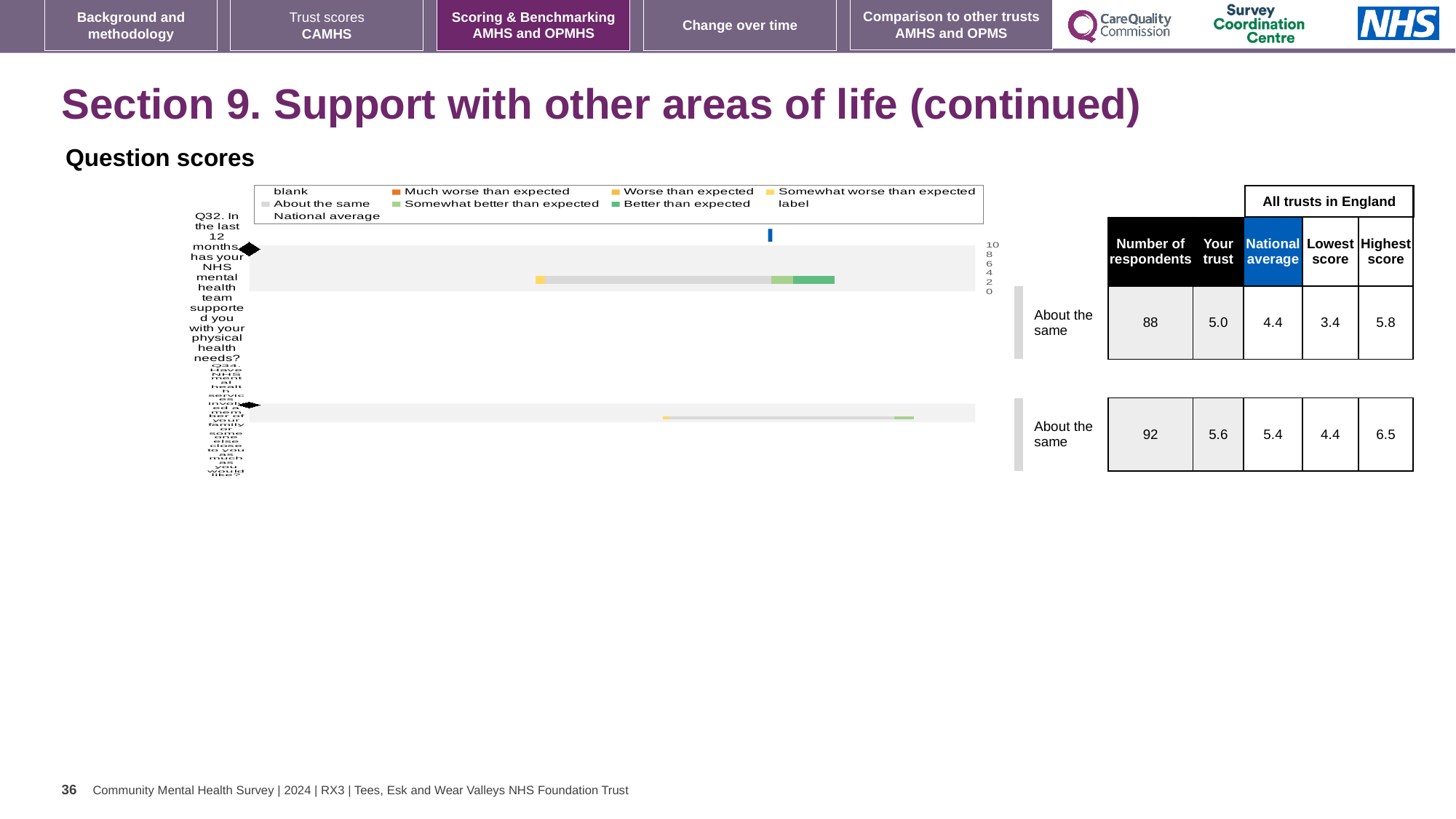
What is the difference between the 'Your trust' score and the national average for Q34? 0.2 What is the number of respondents for Q32 (support with physical health needs)? 88 Which question has the higher 'Your trust' score, Q32 or Q34? Q34 What is the highest score among all trusts in England for Q34? 6.5 What is the lowest score among all trusts in England for Q32? 3.4 What is the 'Your trust' score for Q32? 5.0 How many questions are plotted in the question scores chart? 2 What is the national average score for Q32? 4.4 What benchmark category is shown for both Q32 and Q34? About the same What is the number of respondents for Q34? 92 What kind of chart is used to show the question scores on this slide? bar chart What is the difference between the highest and lowest scores for Q32? 2.4